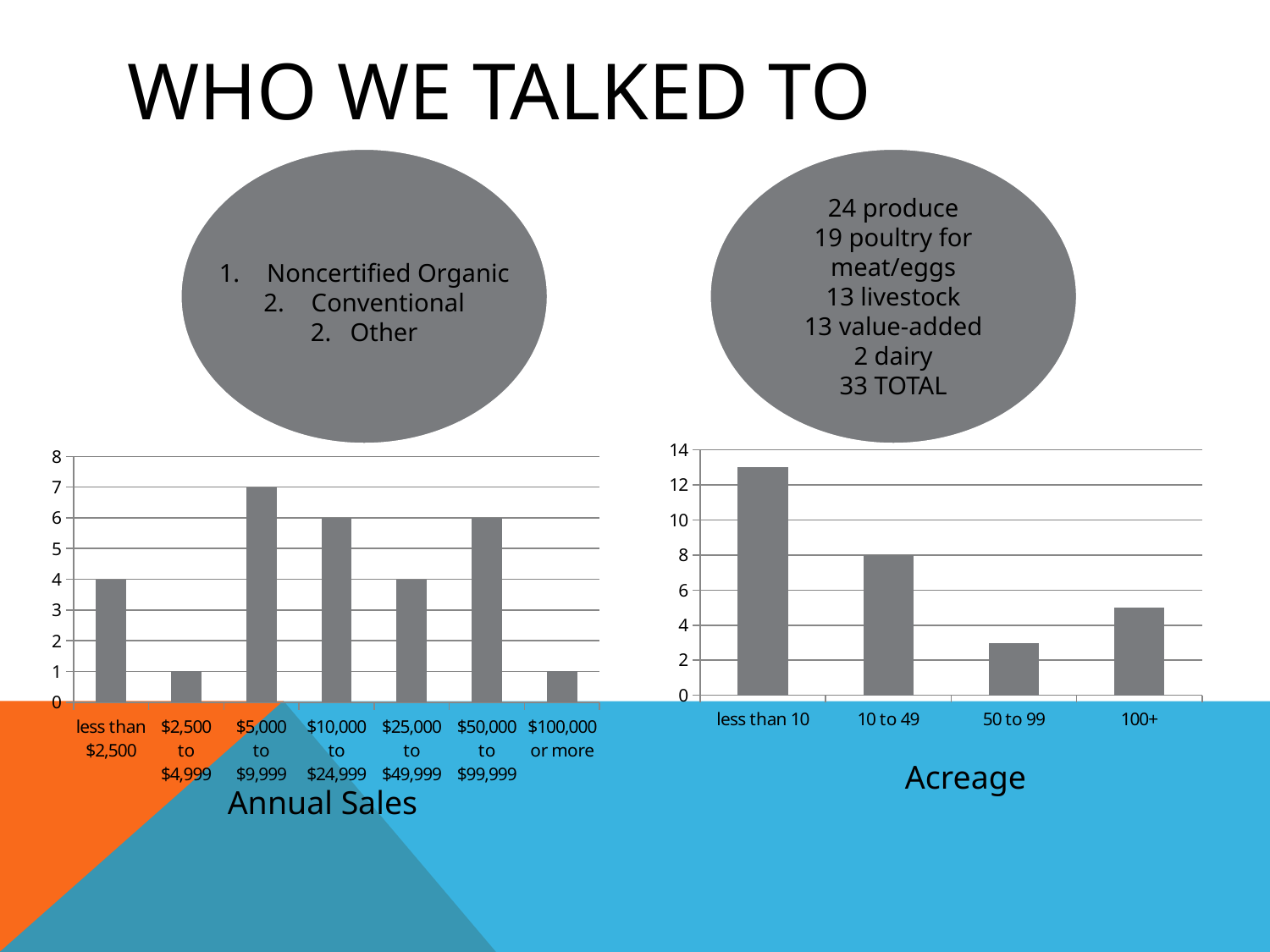
In the Annual Sales chart, what is the difference between the values for $5,000 to $9,999 and $2,500 to $4,999? 6 In the Acreage chart, how many acreage categories are shown? 4 In the Annual Sales chart, which is larger, the value for $25,000 to $49,999 or the value for $50,000 to $99,999? $50,000 to $99,999 In the Annual Sales chart, what is the value for $5,000 to $9,999? 7 In the Acreage chart, is the value for less than 10 greater or less than 12? greater In the Annual Sales chart, what is the value for less than $2,500? 4 In the Annual Sales chart, what kind of chart is shown? bar chart In the Annual Sales chart, what is the value for $10,000 to $24,999? 6 In the Annual Sales chart, how many sales categories are shown on the x axis? 7 In the Annual Sales chart, which category has the highest value? $5,000 to $9,999 In the Acreage chart, which category has the lowest value? 50 to 99 In the Acreage chart, what is the value for 10 to 49? 8